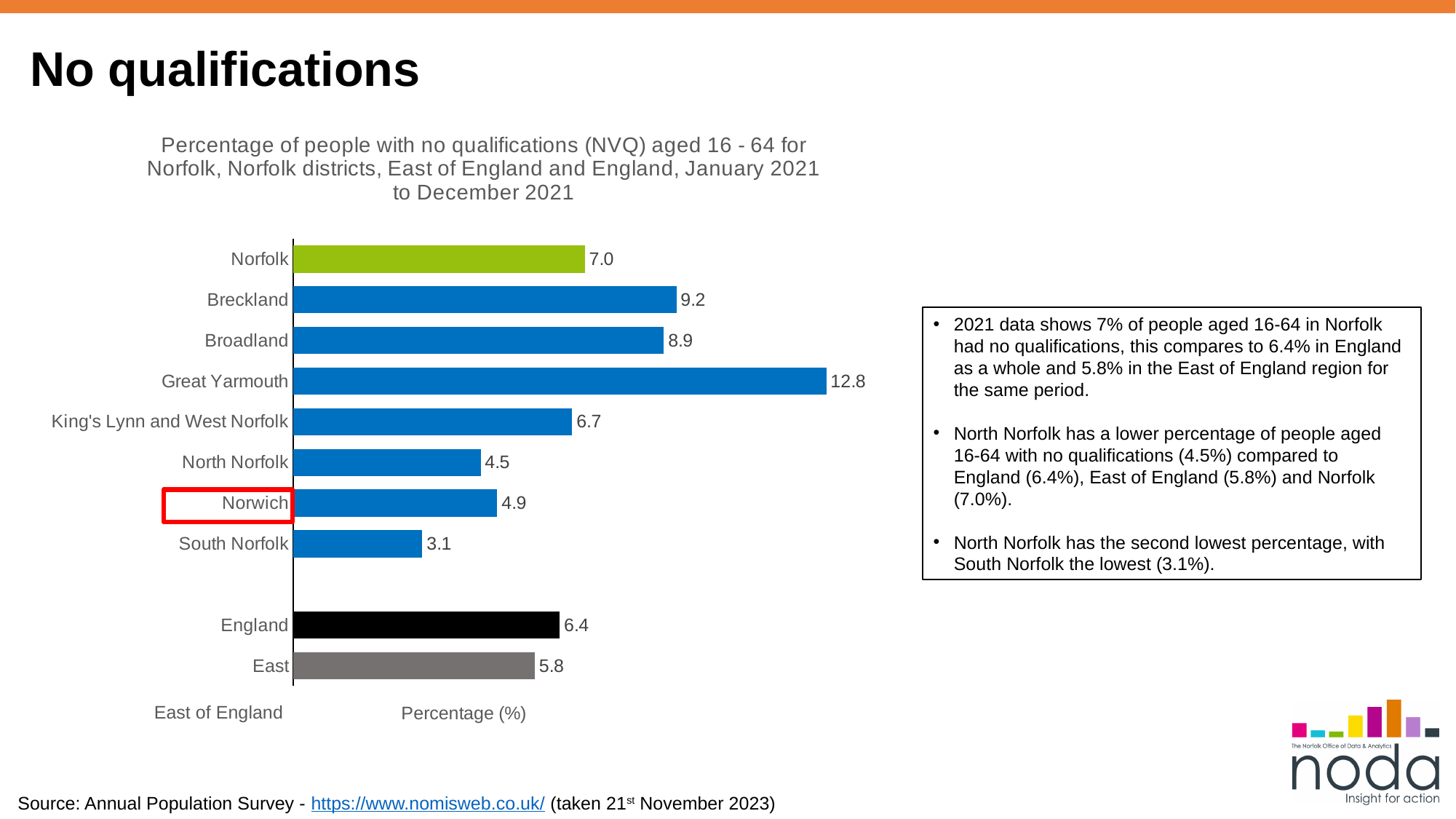
Which has a higher value, King's Lynn and West Norfolk or England? King's Lynn and West Norfolk What is the difference between the values for Norfolk and East? 1.2 Which area has the lowest percentage of people with no qualifications? South Norfolk Which area has the highest percentage of people with no qualifications? Great Yarmouth What is the difference between the values for Breckland and Broadland? 0.3 Which bar is highlighted with a red box around its label? Norwich What type of chart is shown on the slide? Bar chart What is the value shown for England? 6.4 What is the value shown for Norwich? 4.9 What is the percentage of people with no qualifications in Great Yarmouth? 12.8 How many bars are plotted in the chart? 10 Which has a higher value, North Norfolk or Norwich? Norwich